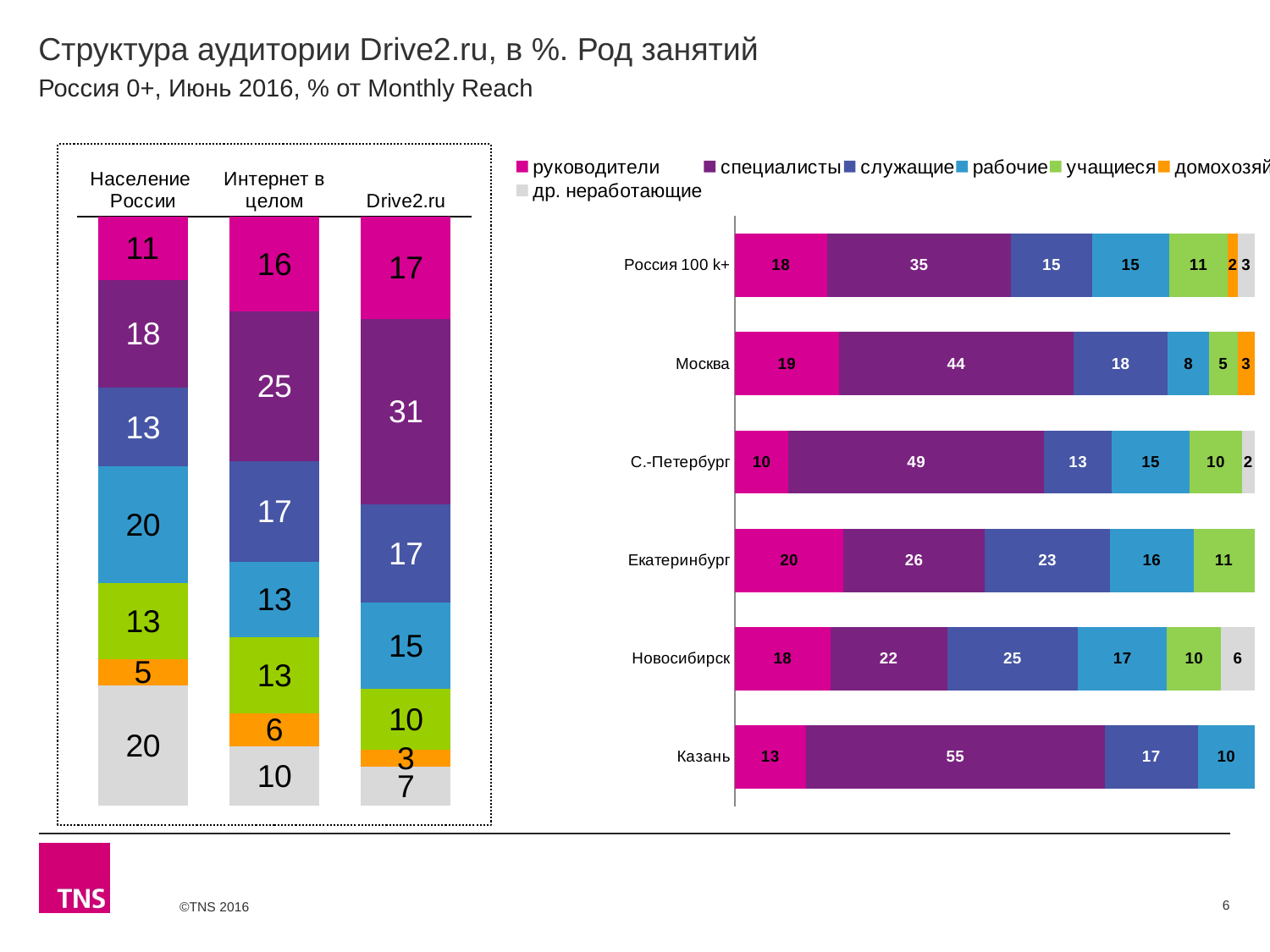
In the left chart, which is larger: the руководители value for Drive2.ru or for Население России? Drive2.ru How many series does the legend of the right chart list? 7 In the left chart, what is the difference between the специалисты values for Drive2.ru and Интернет в целом? 6 In the left chart, what is the value for специалисты in the Drive2.ru bar? 31 In the right chart, what is the value for руководители in Екатеринбург? 20 What kind of chart is the right chart? Stacked bar chart In the right chart, what is the difference between the специалисты values for Москва and Россия 100 k+? 9 In the right chart, which city has the lowest value for руководители? С.-Петербург In the right chart, what is the value for специалисты in Казань? 55 In the left chart, what is the value for рабочие in the Население России bar? 20 In the right chart, which city has the highest value for специалисты? Казань How many cities/regions are shown in the right chart? 6